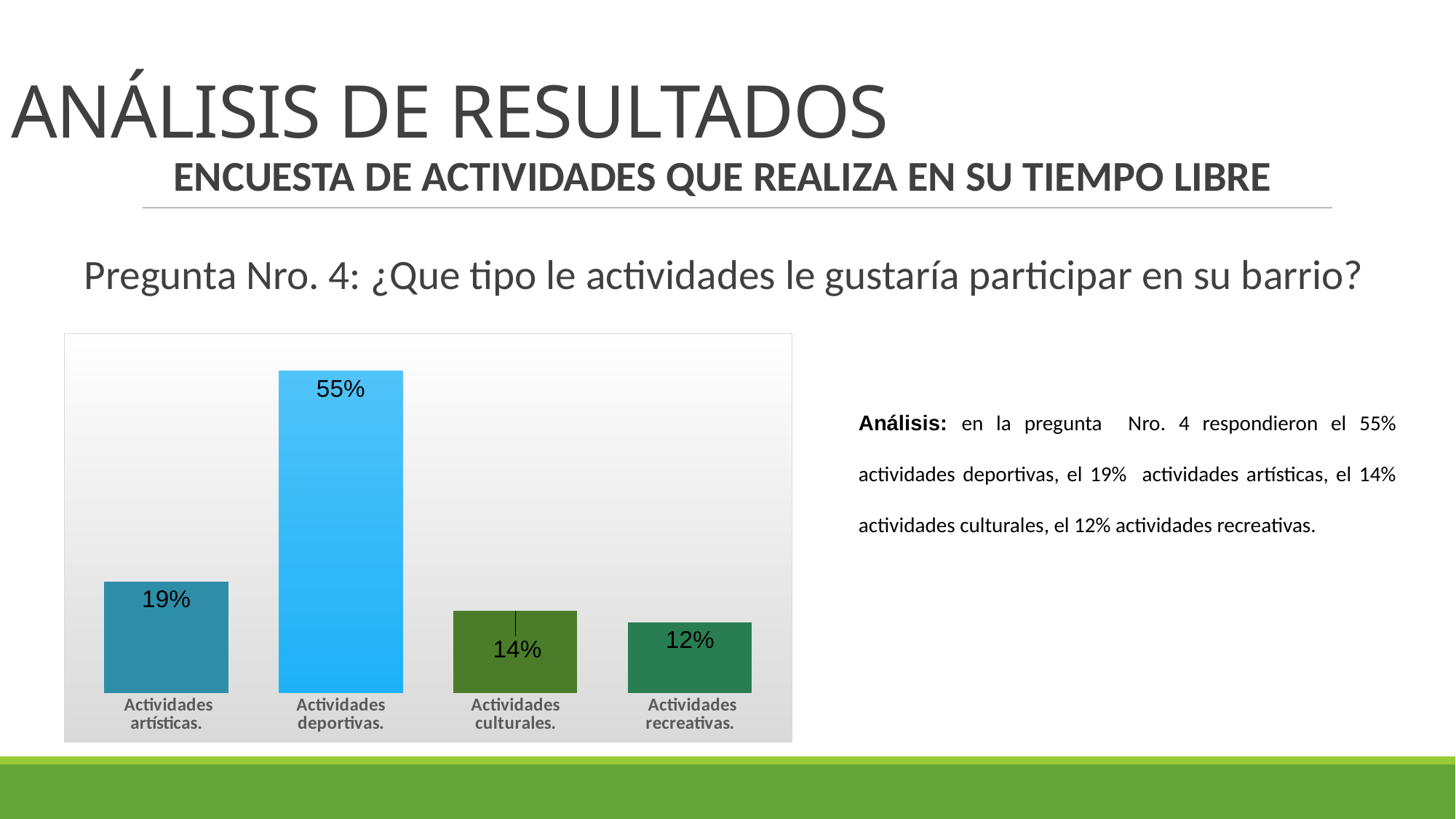
What kind of chart is shown on the slide? Bar chart What is the value for Actividades artísticas? 19% What is the value for Actividades recreativas? 12% What is the difference between the values for Actividades culturales and Actividades recreativas? 2% Which category has the lowest value? Actividades recreativas What is the value for Actividades deportivas? 55% What is the difference between the values for Actividades deportivas and Actividades artísticas? 36% Which is larger, the value for Actividades artísticas or the value for Actividades culturales? Actividades artísticas What colour is the bar for Actividades deportivas? Light blue What is the value for Actividades culturales? 14% Which category has the highest value? Actividades deportivas How many categories are shown in the chart? 4